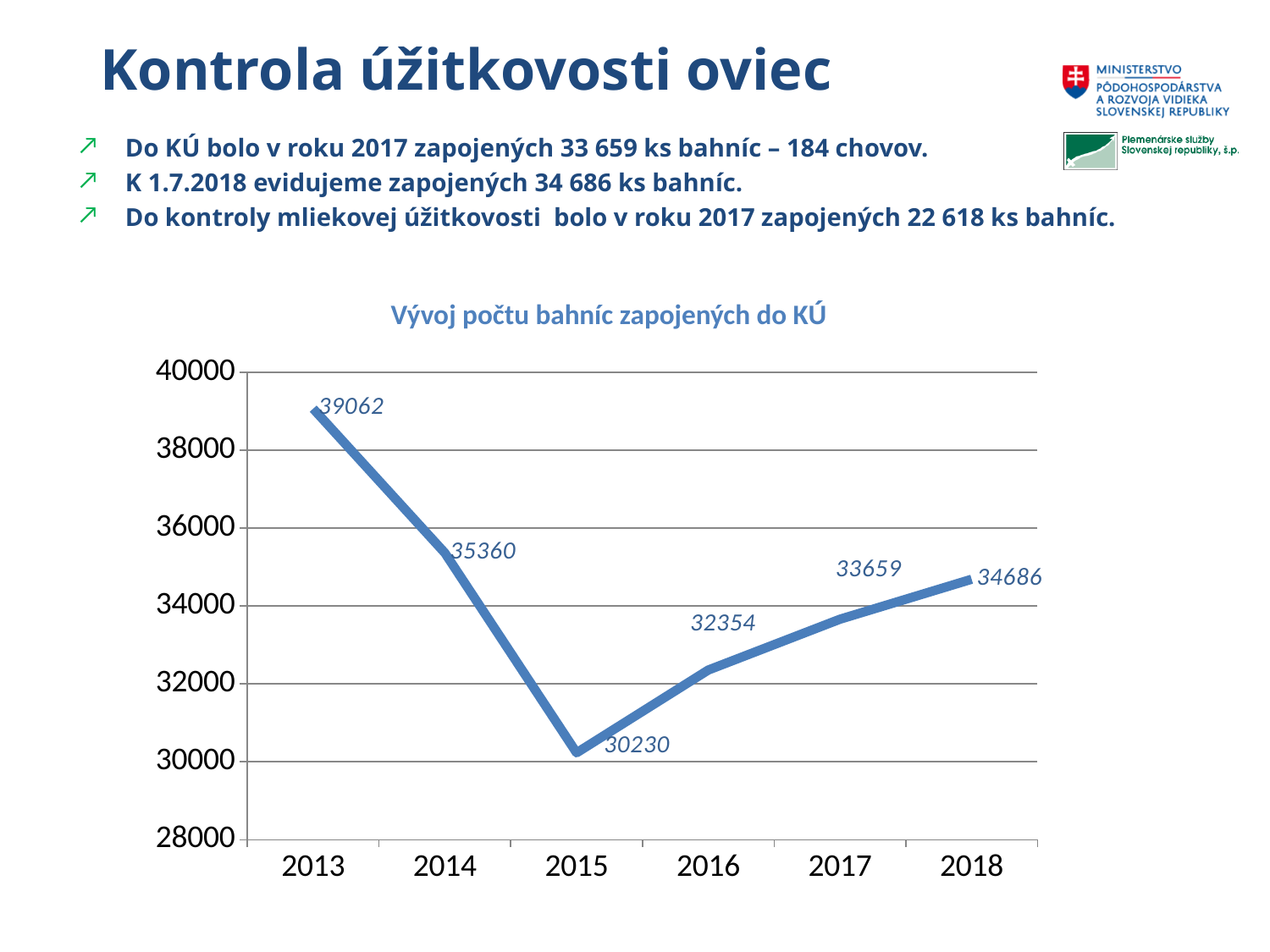
Is the value for 2016 greater or less than 34000? less What is the difference between the values for 2013 and 2015? 8832 What is the value for 2015? 30230 What is the value for 2018? 34686 What kind of chart is shown? line chart Which year has the lowest value? 2015 Which is larger, the value for 2014 or the value for 2016? 2014 What is the difference between the values for 2018 and 2017? 1027 What is the value for 2013? 39062 What is the title of the chart? Vývoj počtu bahníc zapojených do KÚ How many years are plotted on the chart? 6 Which year has the highest value? 2013